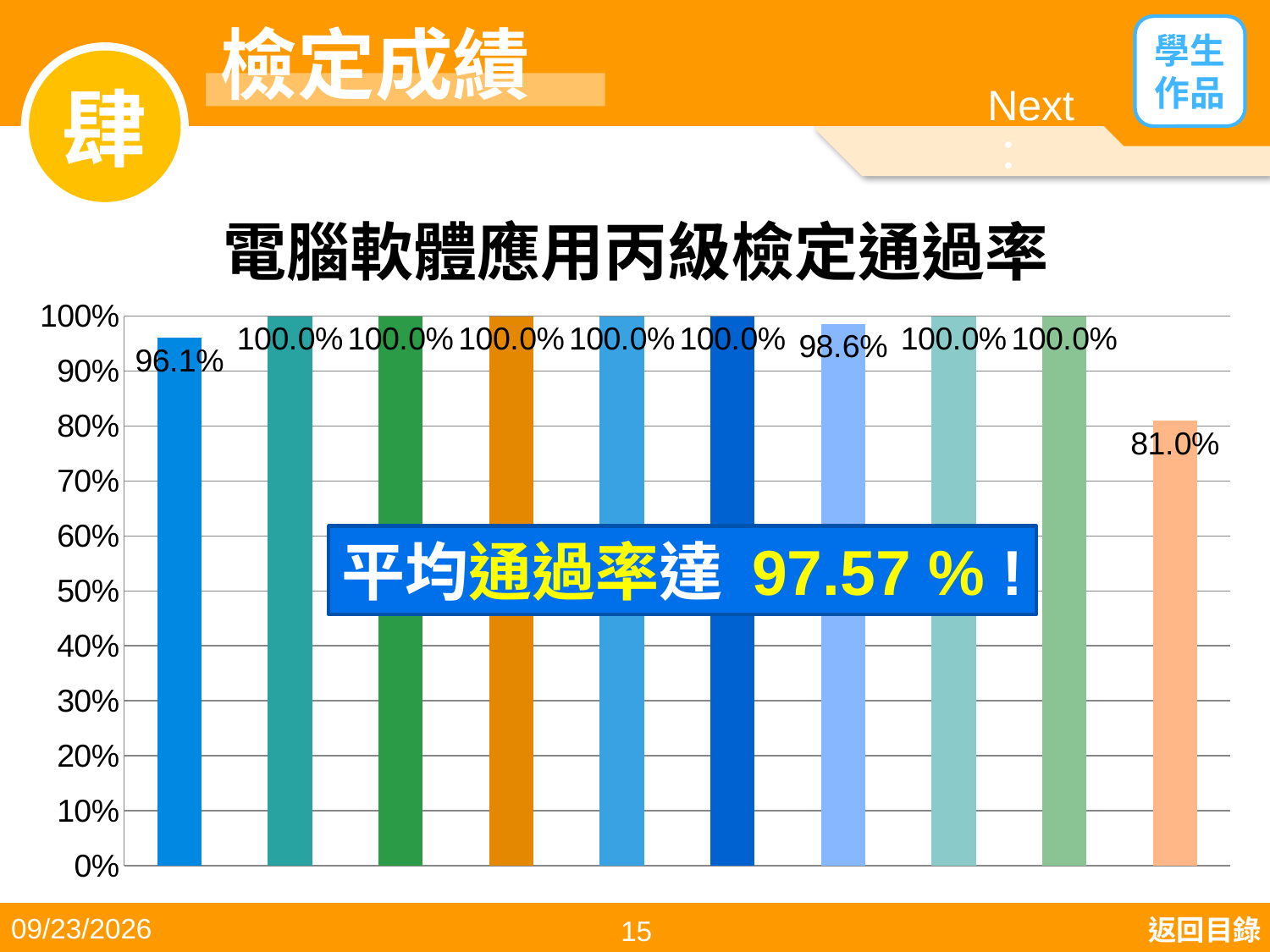
What average pass rate is stated in the text box over the chart? 97.57 % What is the value of the seventh bar from the left in the chart? 98.6% Which bar has the lowest value in the chart? the last (rightmost) bar, 81.0% How many bars in the chart have a value of 100.0%? 7 How many bars are plotted in the chart? 10 What is the difference between the first bar (96.1%) and the last bar (81.0%)? 15.1% Is the value of the rightmost bar greater or less than 90%? less Which is larger, the first bar or the seventh bar? the seventh bar (98.6%) What is the value of the first (leftmost) bar in the chart? 96.1% What is the title of the chart? 電腦軟體應用丙級檢定通過率 What is the value of the last (rightmost) bar in the chart? 81.0% What kind of chart is shown on the slide? bar chart